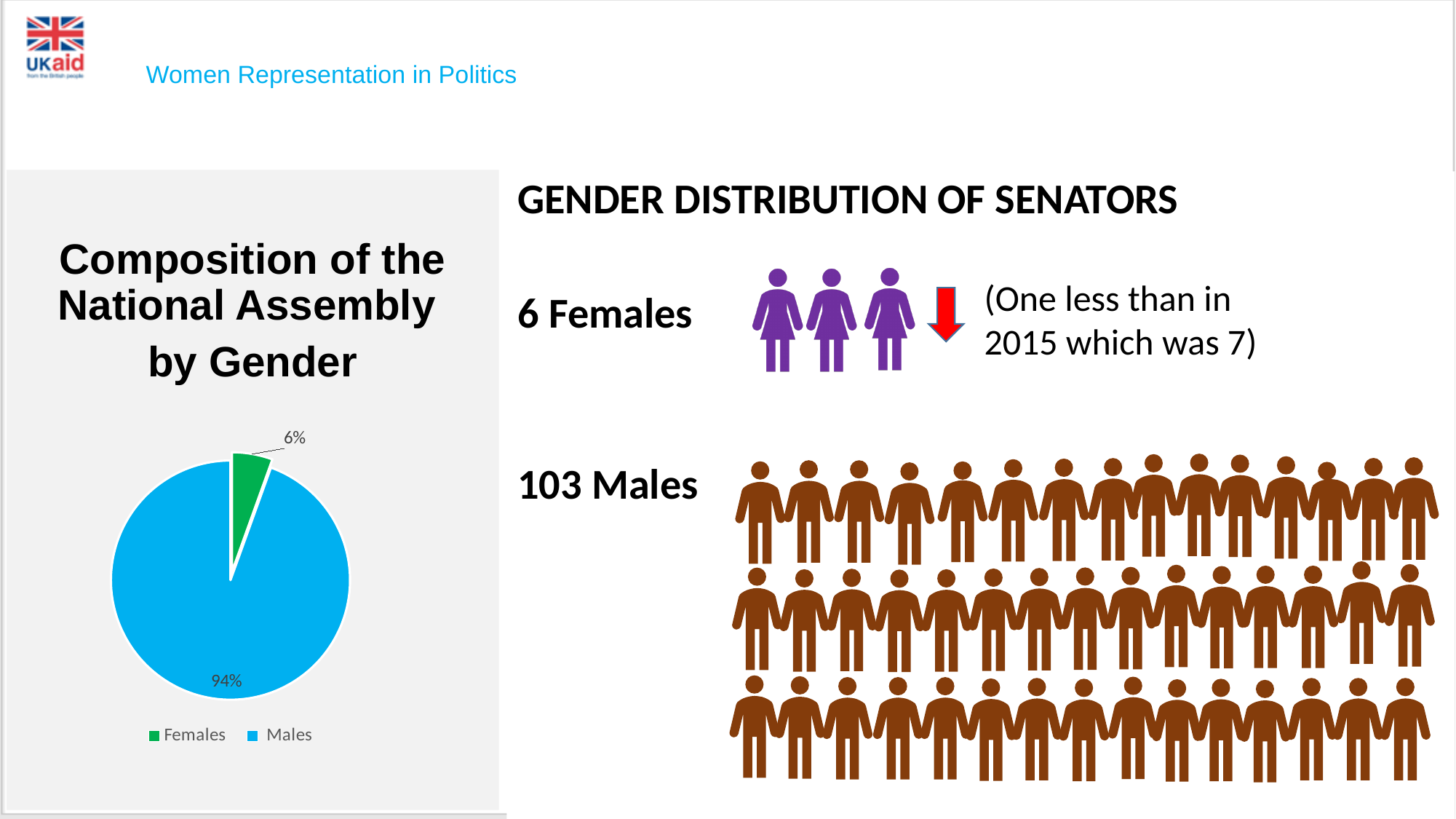
What is the title of the pie chart? Composition of the National Assembly by Gender Which category has the largest slice in the pie chart? Males How many entries does the pie chart legend list? 2 What share of the pie chart is Females? 6% How many categories does the pie chart show? 2 What colour is the Females slice in the pie chart? green What share of the pie chart is Males? 94% Which is larger in the pie chart, Females or Males? Males What kind of chart is shown on the slide? pie chart What is the difference in percentage points between the Males and Females slices? 88 Is the Males share in the pie chart greater or less than 50%? greater Which category has the smallest slice in the pie chart? Females